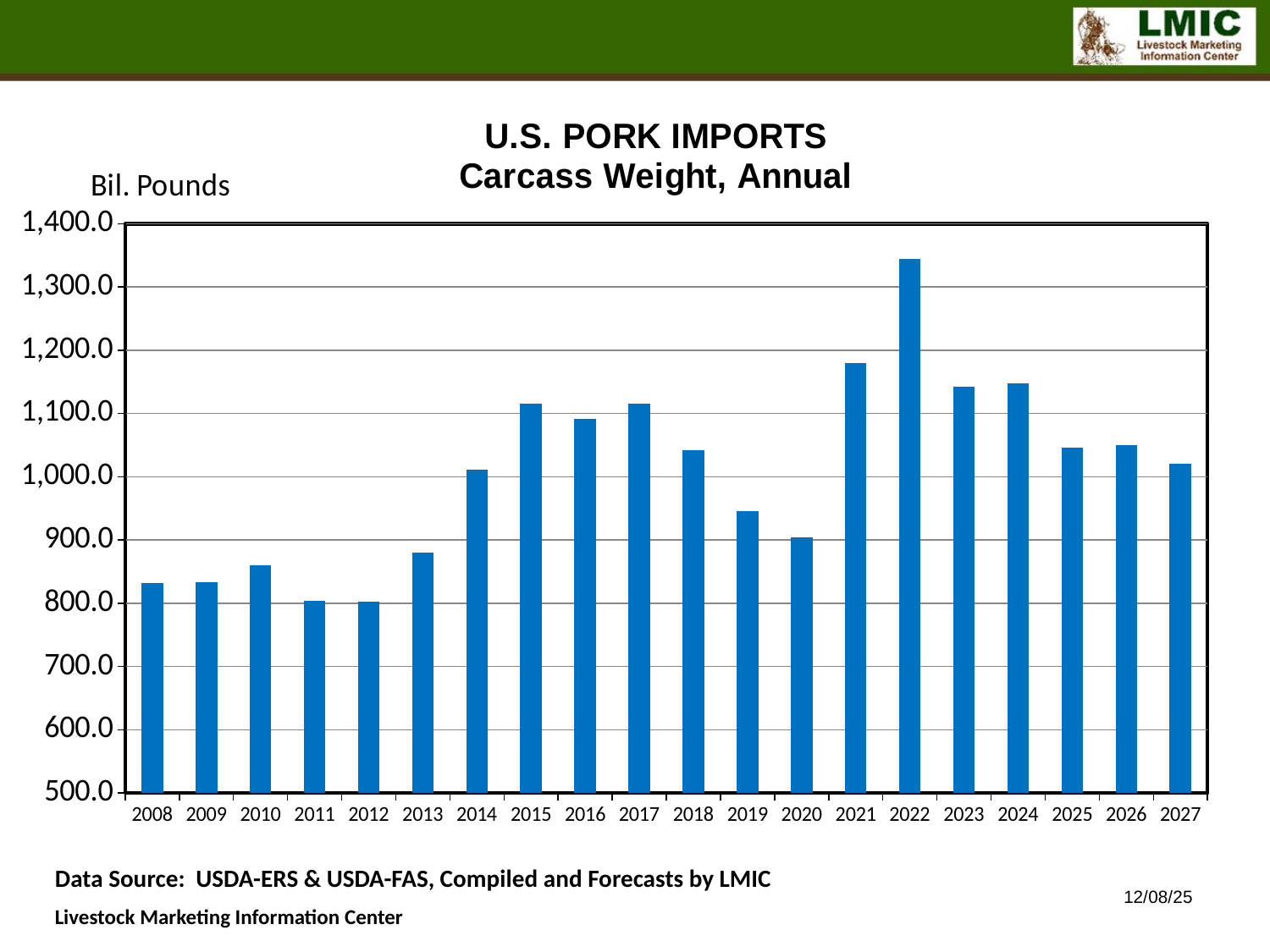
Is the value for 2013 greater or less than 900? less Which year has the larger value, 2021 or 2023? 2021 Which year has the larger value, 2010 or 2013? 2013 Do the values rise or fall from 2018 to 2020? fall What type of chart is shown on the slide? bar chart Is the value for 2021 greater or less than 1,100? greater How many years are plotted on the x axis of the chart? 20 What unit is shown on the y axis label of the chart? Bil. Pounds Is the value for 2022 greater or less than 1,300? greater Which year has the highest U.S. pork imports in the chart? 2022